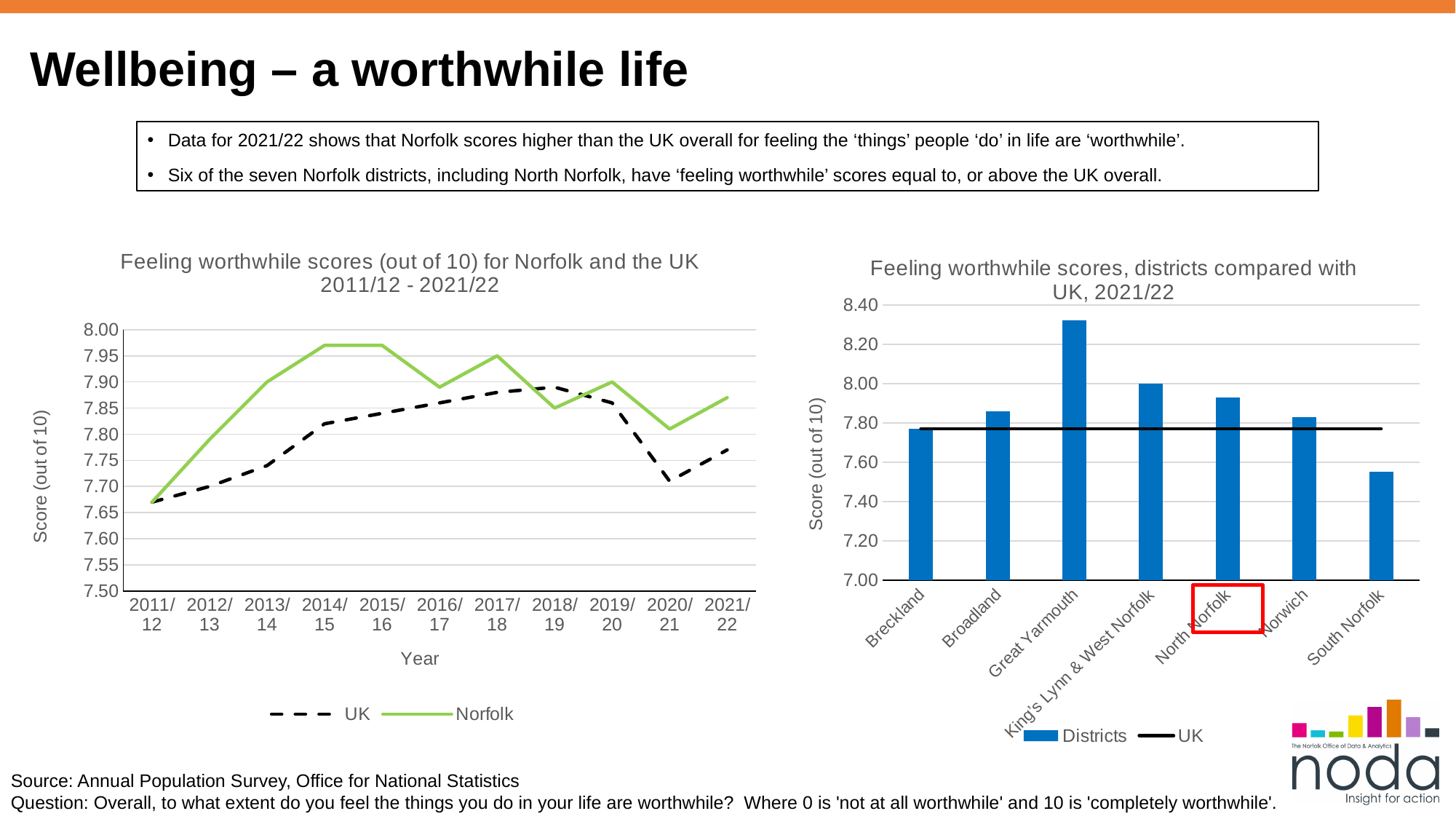
In the right chart, which is larger, the score for Broadland or the score for Great Yarmouth? Great Yarmouth In the left chart, how many years are shown on the x axis? 11 In the right chart, which district has the highest feeling worthwhile score? Great Yarmouth What kind of chart is the left chart, 'Feeling worthwhile scores (out of 10) for Norfolk and the UK 2011/12 - 2021/22'? line chart What kind of chart is the right chart, 'Feeling worthwhile scores, districts compared with UK, 2021/22'? bar chart In the right chart, how many districts are shown? 7 In the right chart, is the value for South Norfolk greater or less than 7.60? less In the right chart, which district has the lowest feeling worthwhile score? South Norfolk In the left chart, how many series does the legend list? 2 In the left chart, does the UK score rise or fall from 2011/12 to 2018/19? rise In the left chart, which series has the higher score in 2021/22, UK or Norfolk? Norfolk In the right chart, is the value for Great Yarmouth greater or less than 8.20? greater